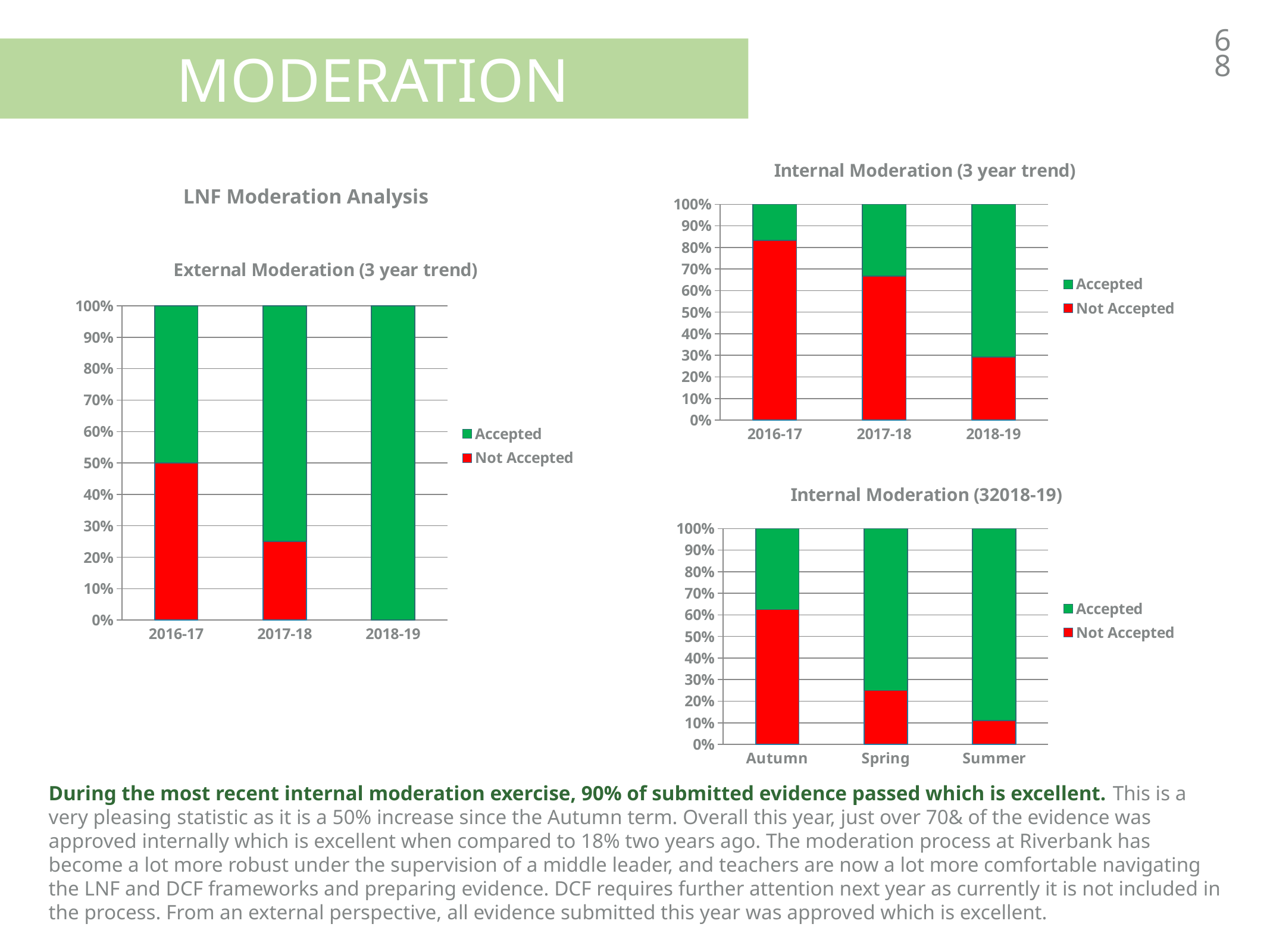
In the Internal Moderation (3 year trend) chart, is the Not Accepted value for 2018-19 greater or less than 40%? less What kind of chart is the External Moderation (3 year trend) chart? Stacked bar chart In the Internal Moderation (32018-19) chart, which term has the highest Accepted share? Summer In the Internal Moderation (3 year trend) chart, is the Not Accepted value for 2016-17 greater or less than 80%? greater In the Internal Moderation (32018-19) chart, is the Not Accepted value for Autumn greater or less than 50%? greater How many categories are shown on the x axis of the Internal Moderation (32018-19) chart? 3 In the Internal Moderation (3 year trend) chart, which year has the lowest Not Accepted share? 2018-19 In the External Moderation (3 year trend) chart, does the Not Accepted share rise or fall from 2016-17 to 2018-19? fall How many series does the legend of the Internal Moderation (3 year trend) chart list? 2 Which colour represents Not Accepted in the Internal Moderation (3 year trend) chart? Red